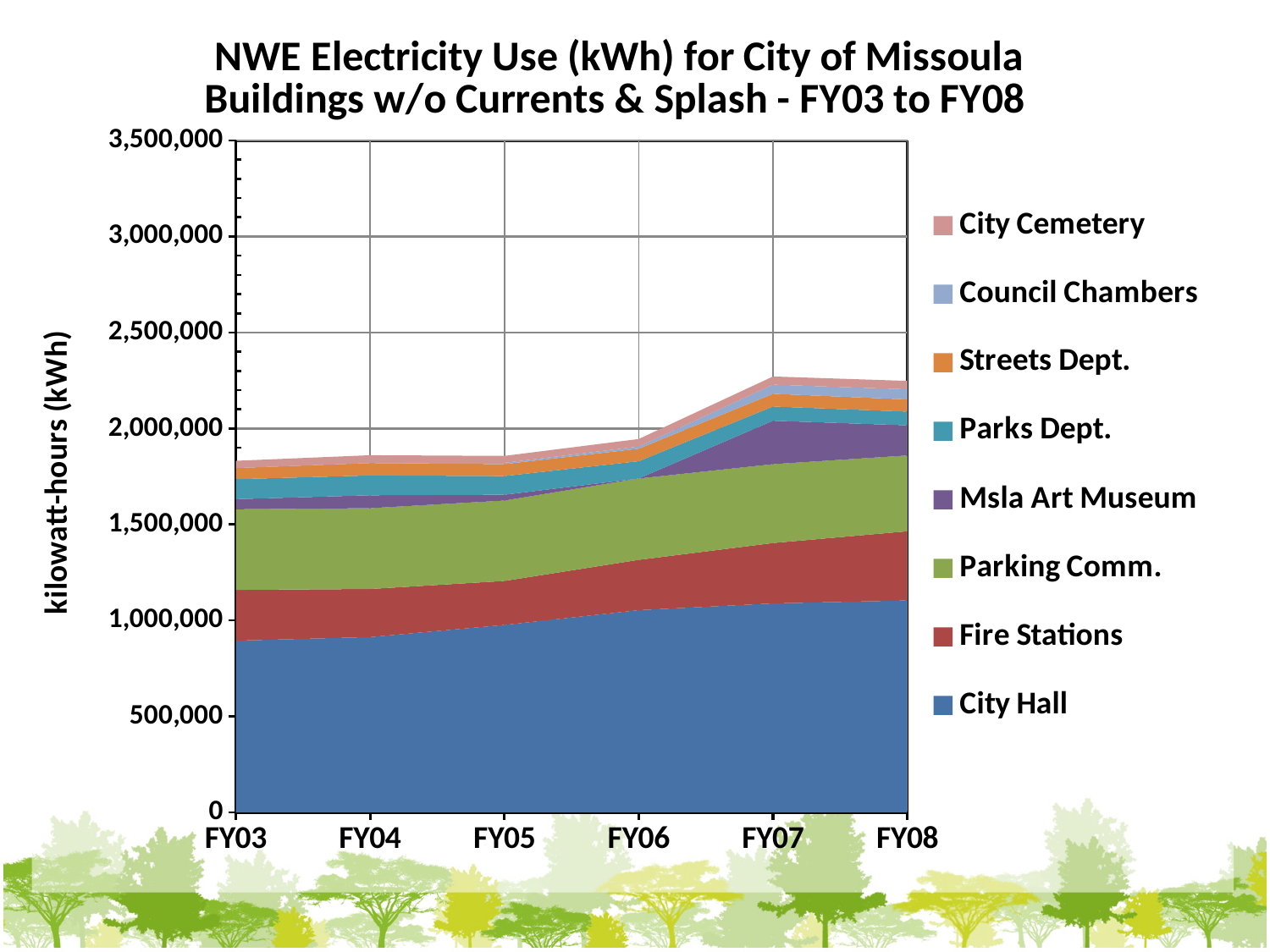
What is the label on the y axis? kilowatt-hours (kWh) What kind of chart is shown on the slide? Stacked area chart Is the value for City Hall in FY08 greater or less than 1,000,000? greater Which series is listed first (at the top) in the legend? City Cemetery How many series does the legend list? 8 Is the total electricity use in FY08 greater or less than 2,500,000? less Does City Hall's electricity use rise or fall from FY03 to FY08? rise Which building or department accounts for the largest share of electricity use in every year shown? City Hall Is the total electricity use in FY07 greater or less than 2,000,000? greater How many fiscal years are shown along the x axis? 6